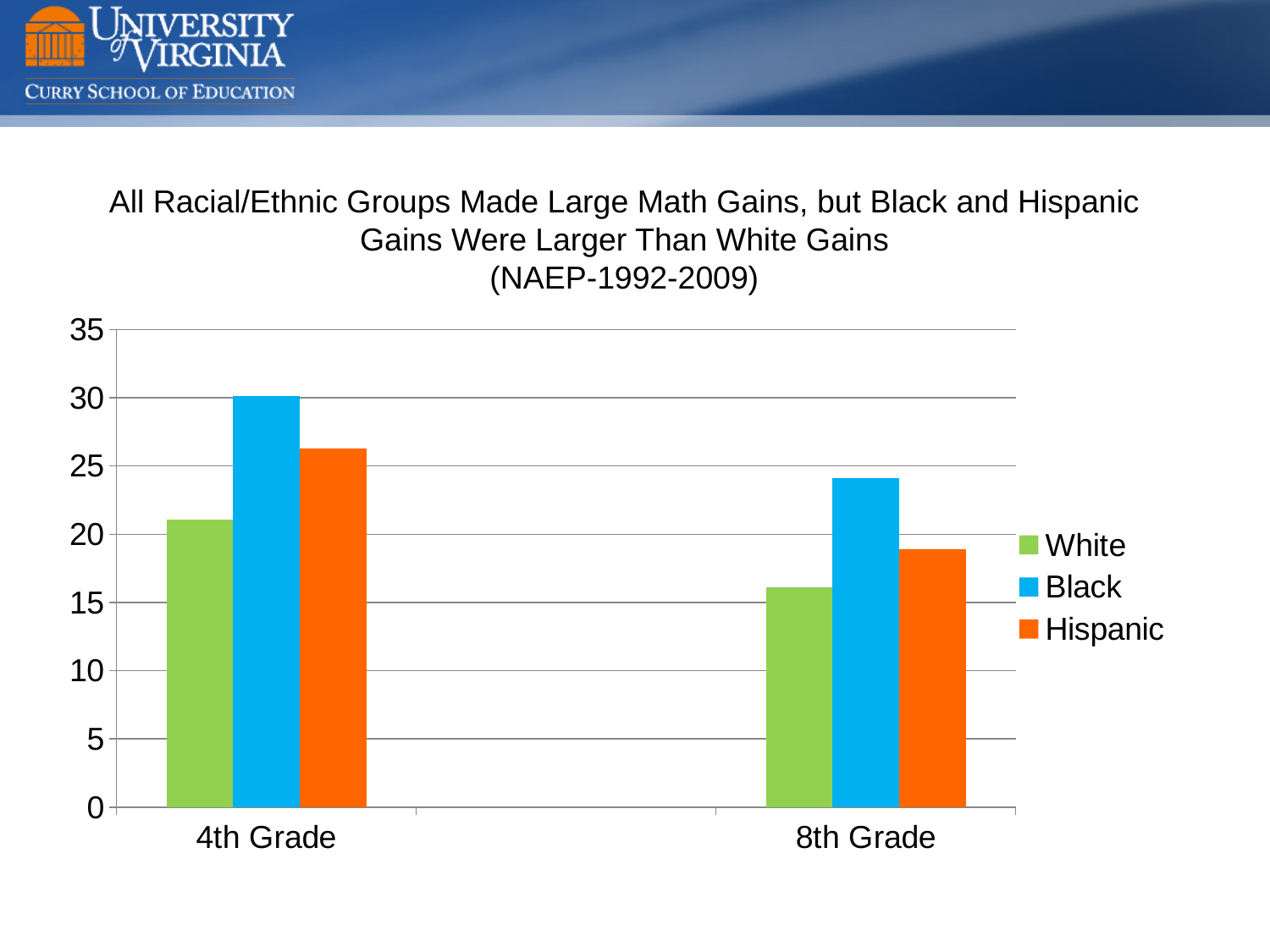
Is the value for White in 8th Grade greater or less than 20? less Is the value for Hispanic in 4th Grade greater or less than 20? greater Which is larger for 8th Grade, the Black bar or the Hispanic bar? Black What kind of chart is shown on the slide? bar chart Is the Hispanic bar larger for 4th Grade or for 8th Grade? 4th Grade How many grade-level categories are shown on the x axis? 2 Which group has the highest bar for 4th Grade? Black What colour represents Hispanic in the legend? orange Is the value for Black in 4th Grade greater or less than 25? greater Which group has the lowest bar for 8th Grade? White How many series does the legend list? 3